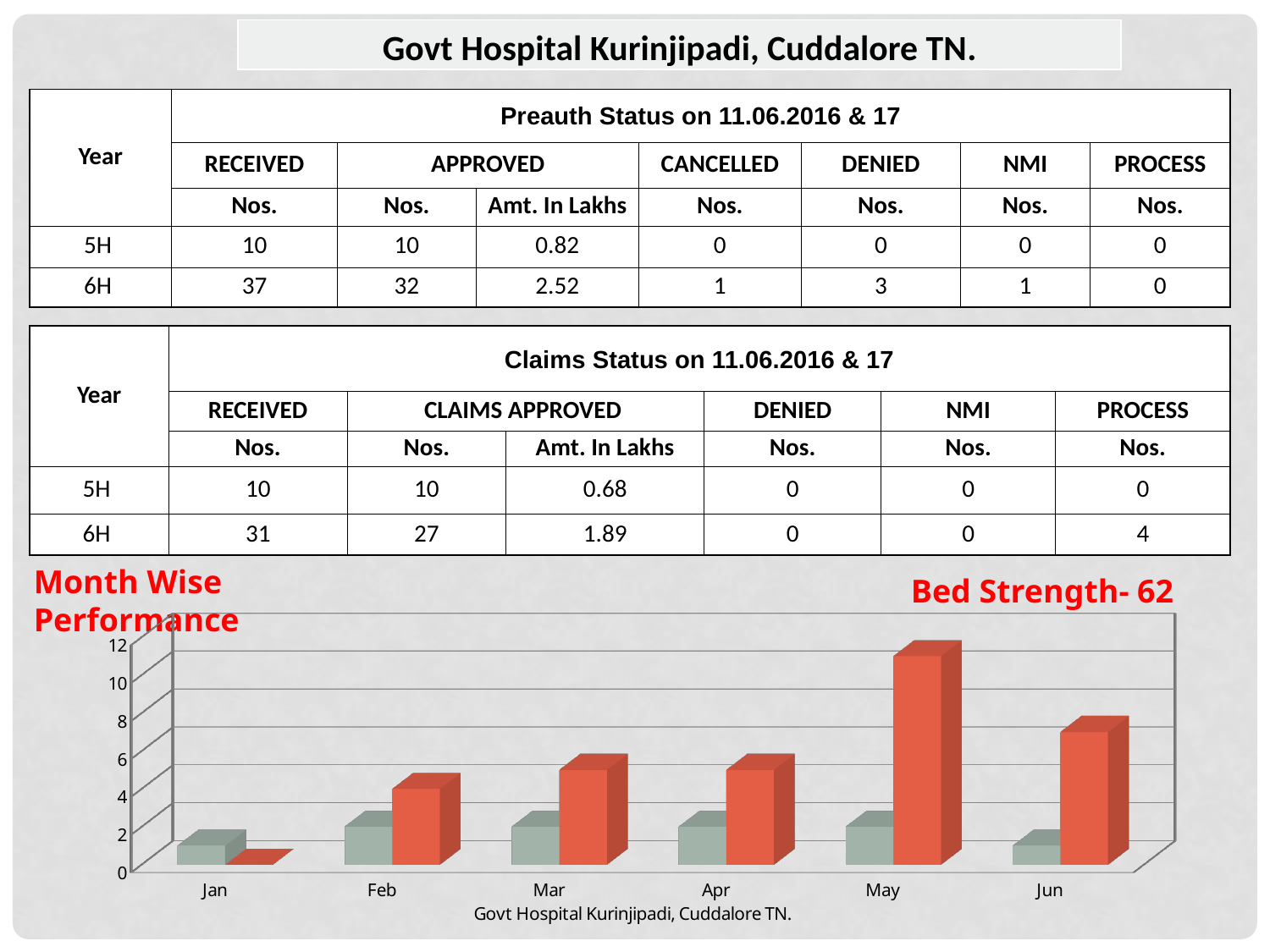
Which month has the taller red bar, Feb or Jun? Jun Is the red bar for May greater or less than 10? greater In which month is the red bar the tallest? May In which month is the red bar the shortest? Jan What kind of chart is shown at the bottom of the slide? bar chart Which month has the taller red bar, May or Jun? May How many bars are plotted for each month in the chart? 2 Is the grey bar for Feb greater or less than 4? less Is the red bar for Feb greater or less than 6? less What text appears below the x axis of the chart? Govt Hospital Kurinjipadi, Cuddalore TN. How many months are shown on the x axis of the chart? 6